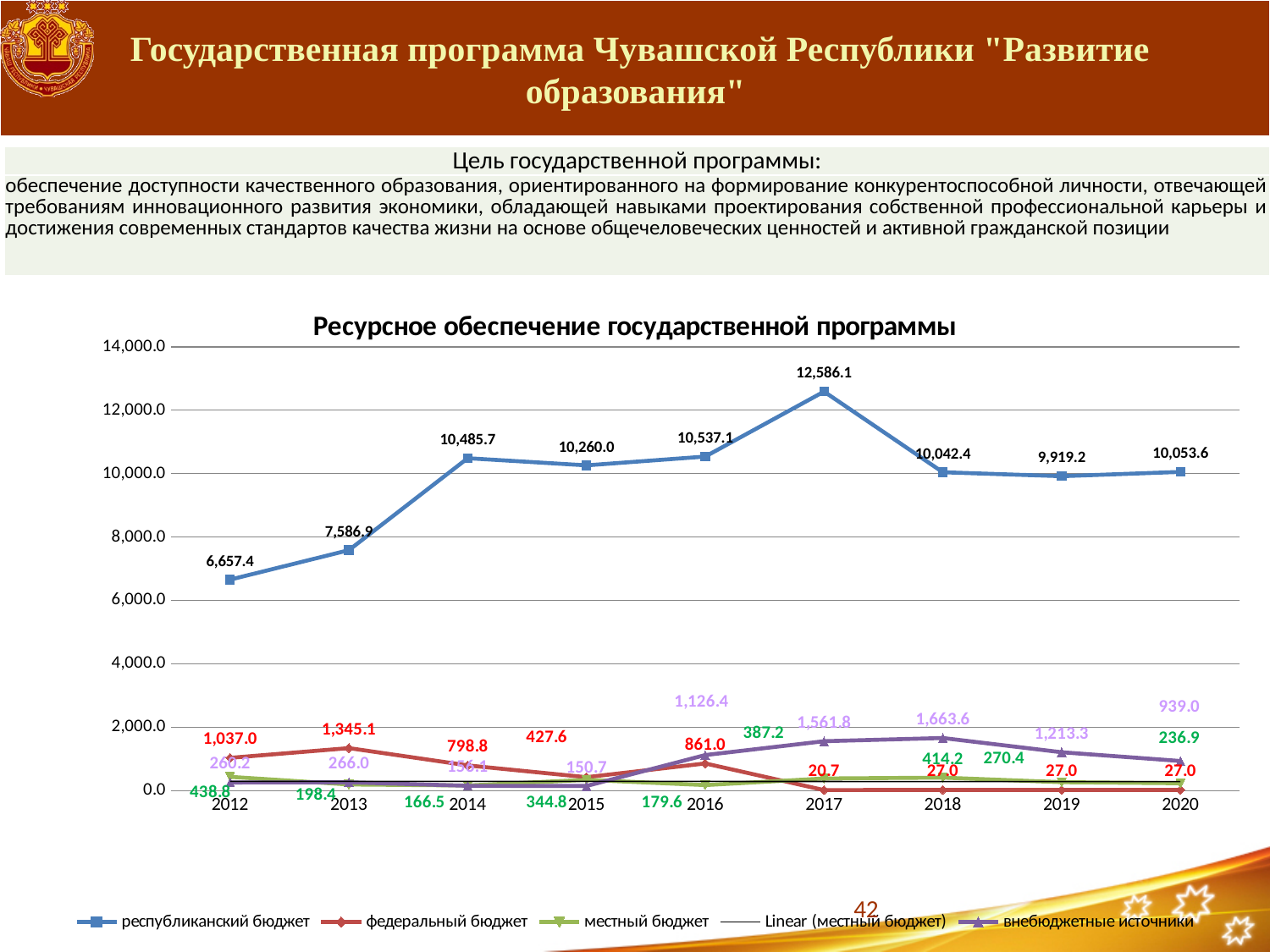
How many years are shown on the x axis? 9 How many entries does the legend list? 5 In which year is the value for республиканский бюджет highest? 2017 What is the value for внебюджетные источники in 2018? 1,663.6 In which year is the value for республиканский бюджет lowest? 2012 What type of chart is shown on the slide? line chart What is the title of the chart? Ресурсное обеспечение государственной программы Which is larger in 2016: федеральный бюджет or внебюджетные источники? внебюджетные источники What is the difference between the республиканский бюджет values for 2017 and 2018? 2,543.7 What is the value for республиканский бюджет in 2012? 6,657.4 What is the value for федеральный бюджет in 2013? 1,345.1 What is the value for республиканский бюджет in 2017? 12,586.1